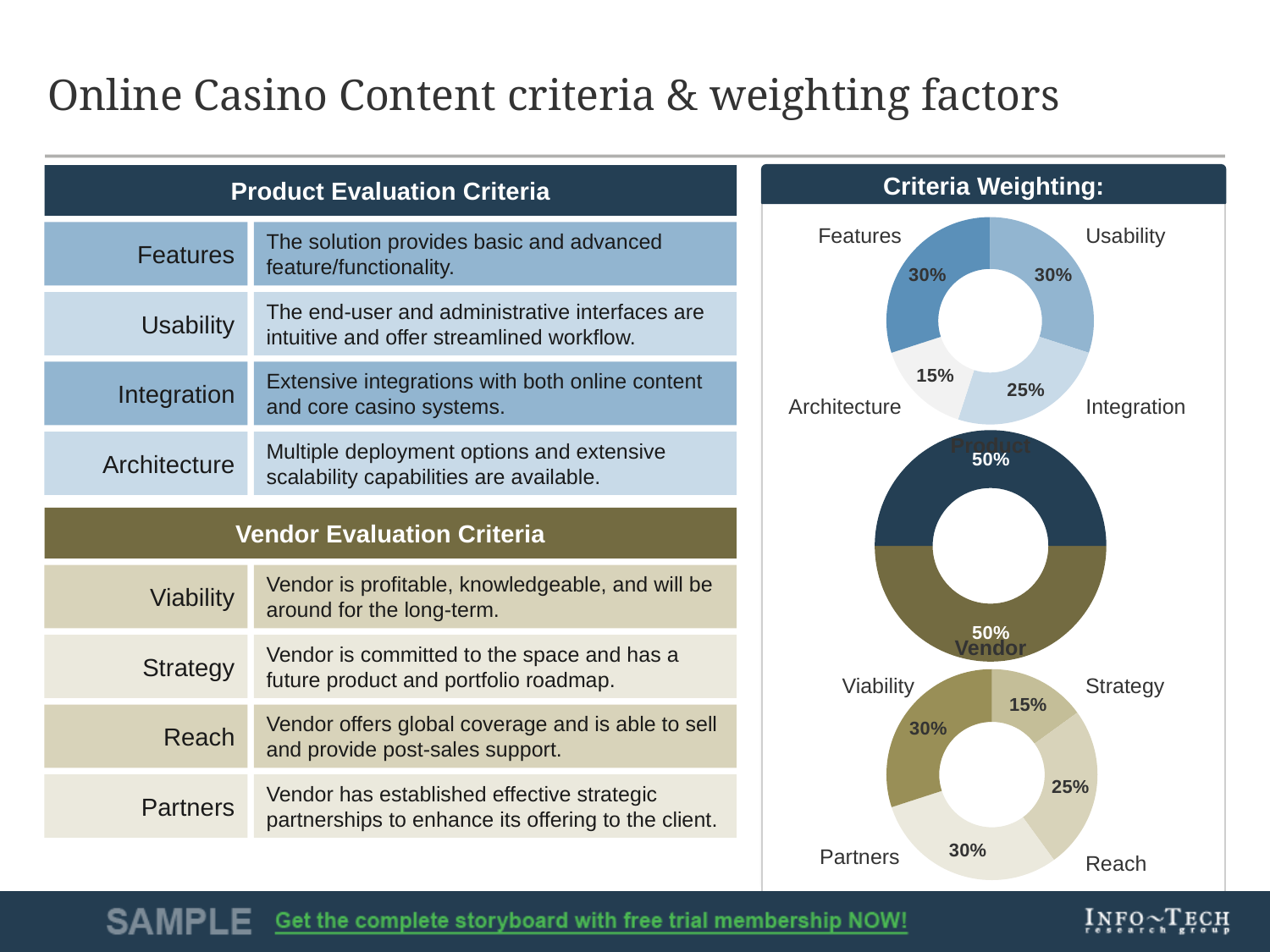
In the top donut chart under Criteria Weighting, what is the difference between the weightings for Features and Architecture? 15% In the bottom donut chart under Criteria Weighting, what is the difference between the weightings for Partners and Strategy? 15% In the top donut chart under Criteria Weighting, what is the weighting for Integration? 25% In the bottom donut chart under Criteria Weighting, which is larger, the weighting for Viability or the weighting for Reach? Viability In the middle donut chart under Criteria Weighting, what is the weighting for Product? 50% What kind of chart is used to show the Criteria Weighting on the slide? Donut chart In the top donut chart under Criteria Weighting, what is the weighting for Architecture? 15% In the top donut chart under Criteria Weighting, which criterion has the lowest weighting? Architecture In the top donut chart under Criteria Weighting, how many criteria are shown? 4 In the bottom donut chart under Criteria Weighting, what is the weighting for Reach? 25% In the bottom donut chart under Criteria Weighting, what is the weighting for Strategy? 15% In the middle donut chart under Criteria Weighting, how many slices are there? 2